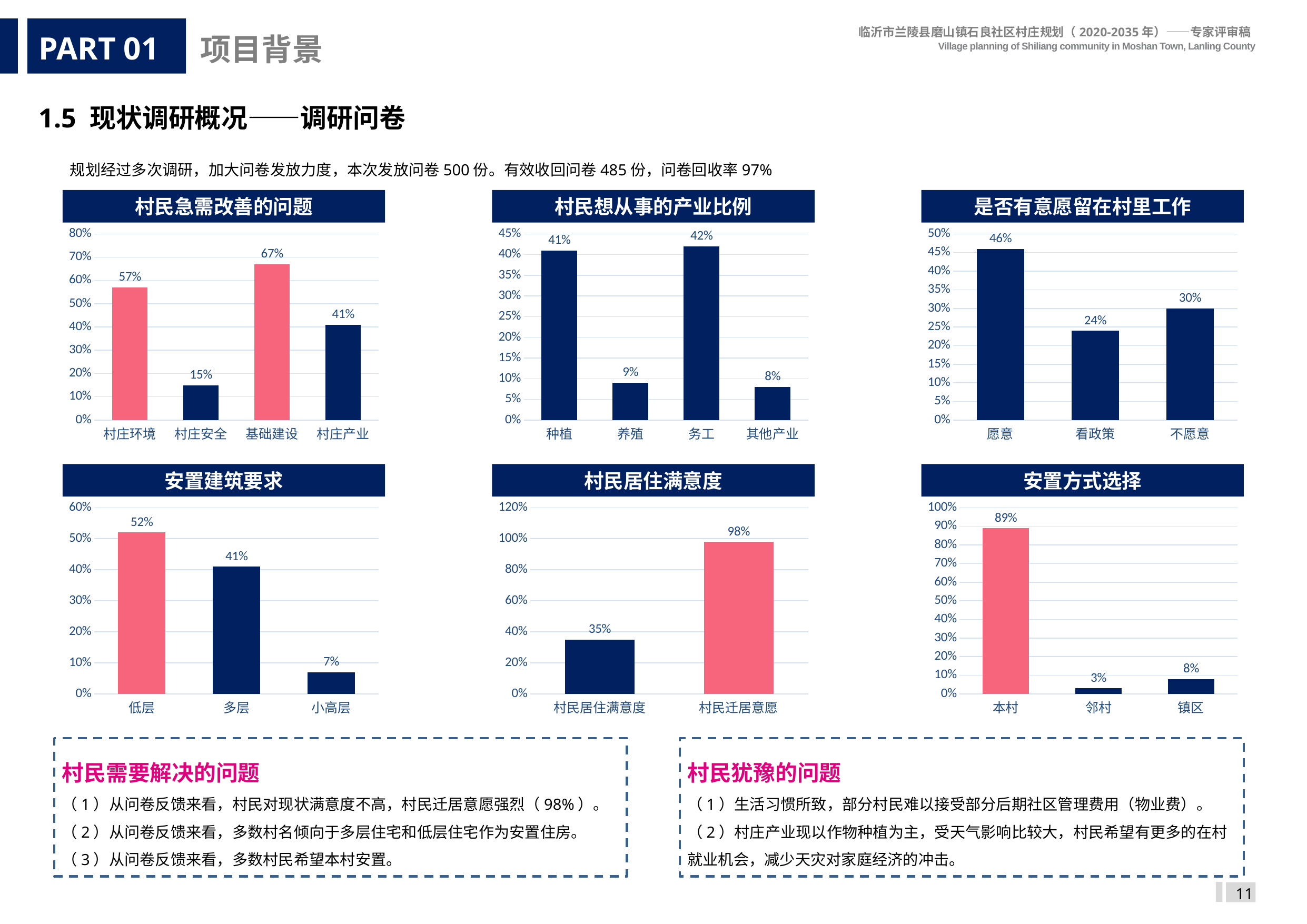
What kind of chart is the one titled 安置方式选择? bar chart In the chart titled 是否有意愿留在村里工作, which category has the highest value? 愿意 In the chart titled 村民居住满意度, what is the difference between 村民迁居意愿 and 村民居住满意度? 63% In the chart titled 安置建筑要求, what is the value for 小高层? 7% In the chart titled 村民急需改善的问题, which category has the lowest value? 村庄安全 In the chart titled 安置方式选择, what is the value for 邻村? 3% In the chart titled 是否有意愿留在村里工作, how many categories are shown? 3 In the chart titled 村民急需改善的问题, what is the value for 基础建设? 67% In the chart titled 村民想从事的产业比例, what is the value for 养殖? 9% In the chart titled 村民居住满意度, what is the value for 村民迁居意愿? 98% In the chart titled 村民想从事的产业比例, what is the difference between 务工 and 其他产业? 34% In the chart titled 安置建筑要求, which is larger, 低层 or 多层? 低层